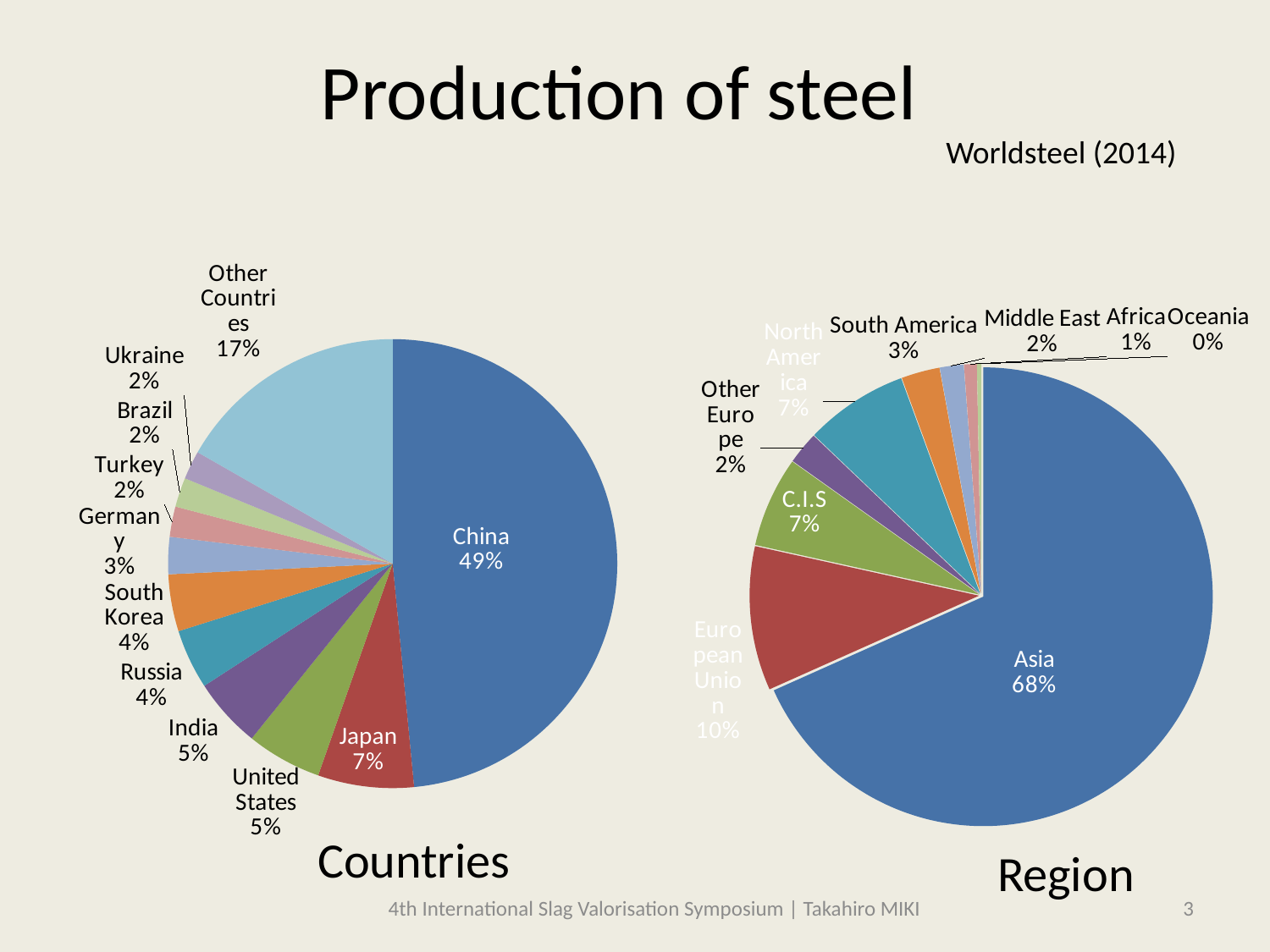
How many slices does the Countries pie chart have? 11 On the Countries pie chart, what share of steel production does China account for? 49% On the Countries pie chart, which is larger, India or Germany? India On the Region pie chart, what share does Asia account for? 68% On the Region pie chart, what is the value shown for C.I.S? 7% On the Countries pie chart, which country has the largest slice? China On the Countries pie chart, what is the value shown for Japan? 7% What kind of chart is the Region chart? Pie chart On the Countries pie chart, what is the value shown for Other Countries? 17% On the Region pie chart, which region has the smallest slice? Oceania On the Region pie chart, which region has the largest slice? Asia On the Countries pie chart, what is the difference between China's share and Japan's share? 42%